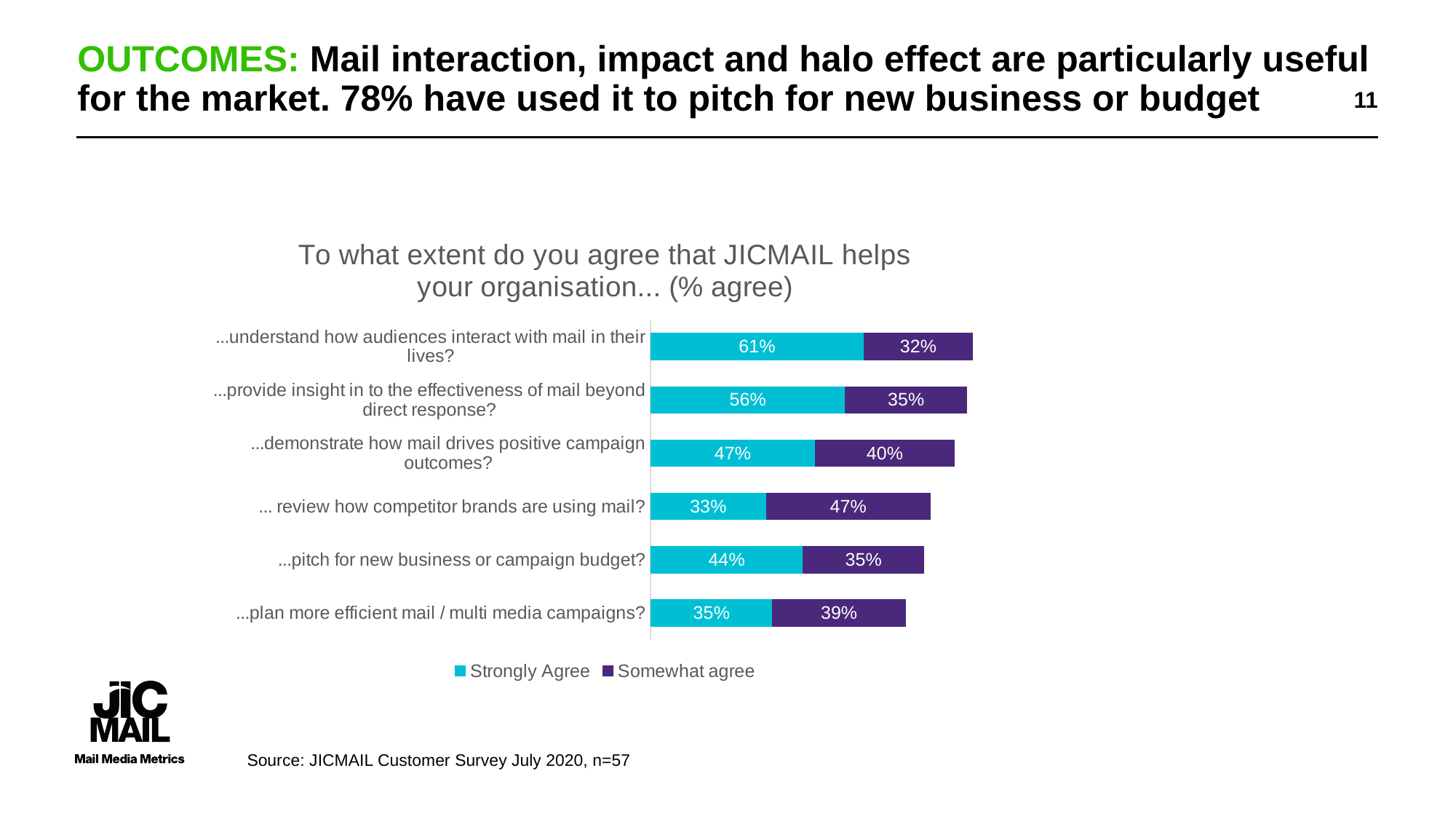
What is the Somewhat agree value for '...review how competitor brands are using mail?' 47% What percentage strongly agree that JICMAIL helps their organisation understand how audiences interact with mail in their lives? 61% Which statement has the highest Strongly Agree percentage? ...understand how audiences interact with mail in their lives? How many statements (categories) are shown in the chart? 6 What is the total (Strongly Agree plus Somewhat agree) for '...pitch for new business or campaign budget?' 79% What is the difference between the Strongly Agree values for '...understand how audiences interact with mail in their lives?' and '...plan more efficient mail / multi media campaigns?' 26% How many series does the legend list? 2 What type of chart is shown on the slide? Stacked bar chart Which statement has the lowest Strongly Agree percentage? ... review how competitor brands are using mail? What is the total (Strongly Agree plus Somewhat agree) for '...understand how audiences interact with mail in their lives?' 93% Which is larger: the Strongly Agree value for '...demonstrate how mail drives positive campaign outcomes?' or for '...pitch for new business or campaign budget?' ...demonstrate how mail drives positive campaign outcomes? What is the Strongly Agree value for '...pitch for new business or campaign budget?' 44%